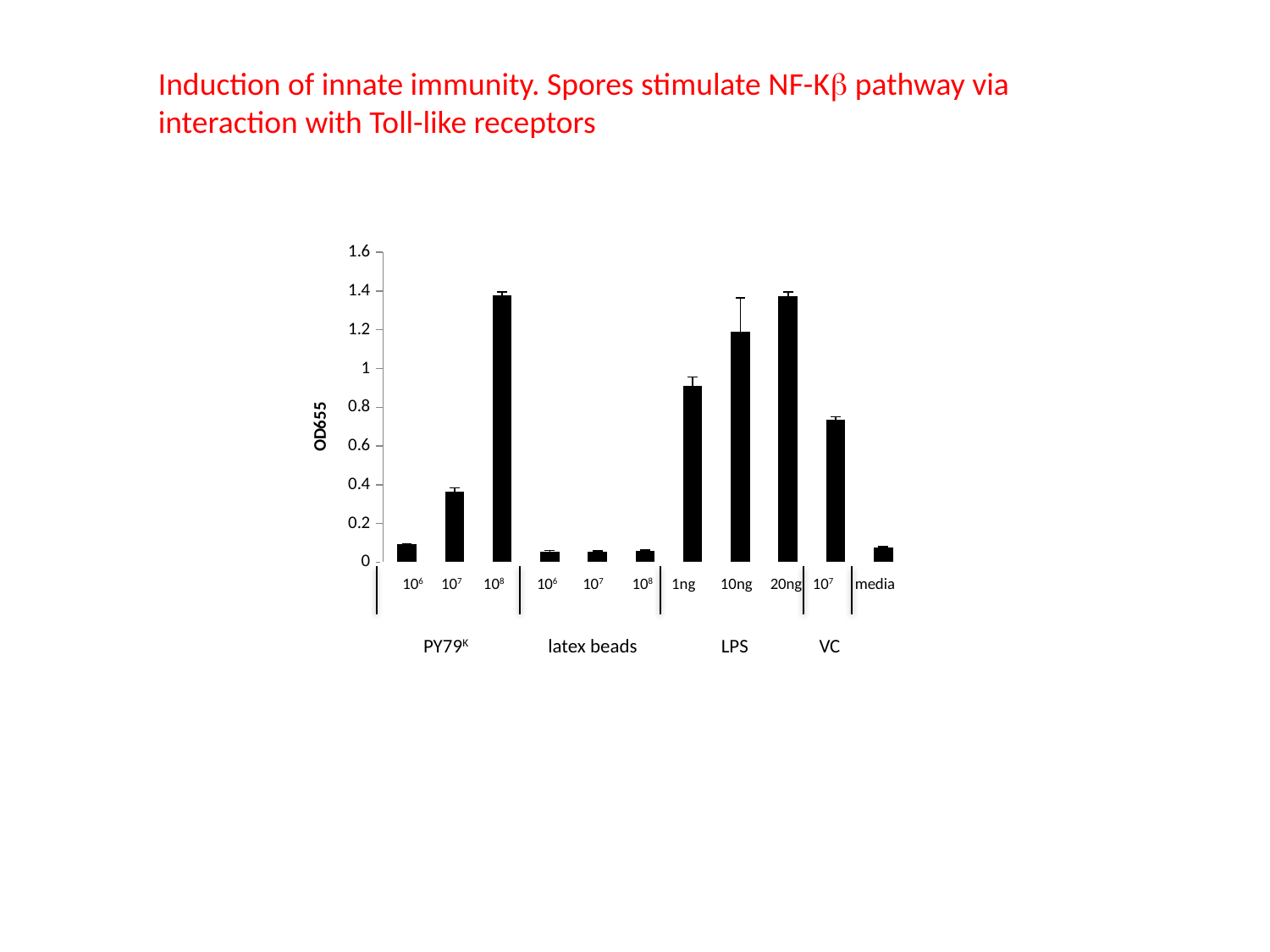
How many bars are plotted in the chart? 11 How many bars are in the PY79K group? 3 What kind of chart is shown on the slide? bar chart What is the label of the y axis? OD655 Which is larger, the value for PY79K at 10^7 or the value for VC at 10^7? VC at 10^7 Within the PY79K group, do the values rise or fall as the dose increases from 10^6 to 10^8? rise Is the value for PY79K at 10^8 greater or less than 1.2? greater Which is larger, the value for LPS at 1ng or the value for LPS at 10ng? LPS at 10ng Is the value for VC at 10^7 greater or less than 1? less Is the value for PY79K at 10^7 greater or less than 0.6? less